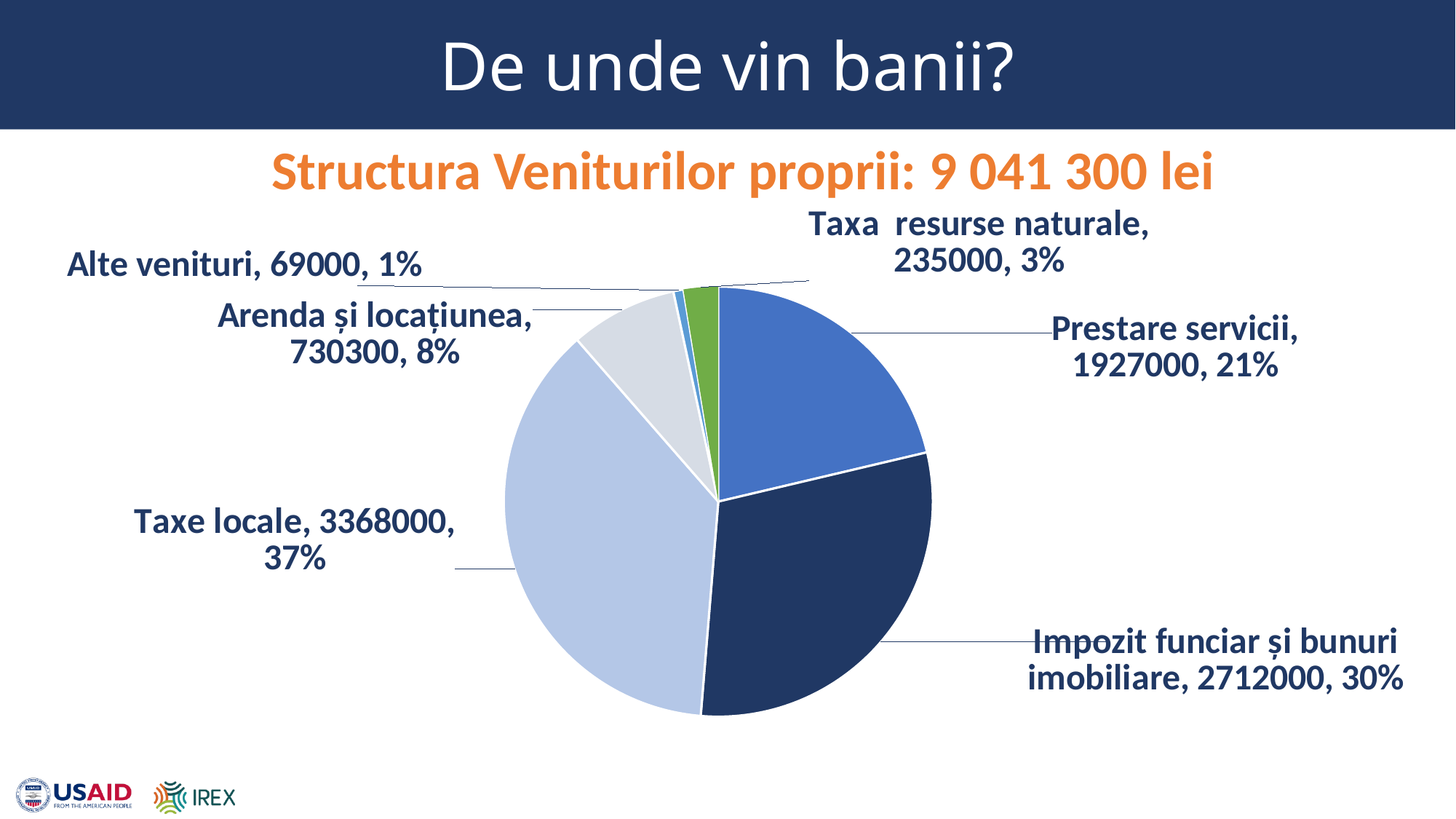
What percentage share does Taxa resurse naturale have? 3% What is the value for Taxe locale? 3368000 What total amount is stated in the chart title? 9 041 300 lei Which category has the smallest slice? Alte venituri Which category has the largest slice? Taxe locale What is the difference between Taxe locale and Impozit funciar și bunuri imobiliare? 656000 What percentage share does Arenda și locațiunea have? 8% Which is larger, Prestare servicii or Arenda și locațiunea? Prestare servicii What is the value for Prestare servicii? 1927000 How many categories are shown in the pie chart? 6 What is the value for Impozit funciar și bunuri imobiliare? 2712000 What type of chart is shown on the slide? pie chart